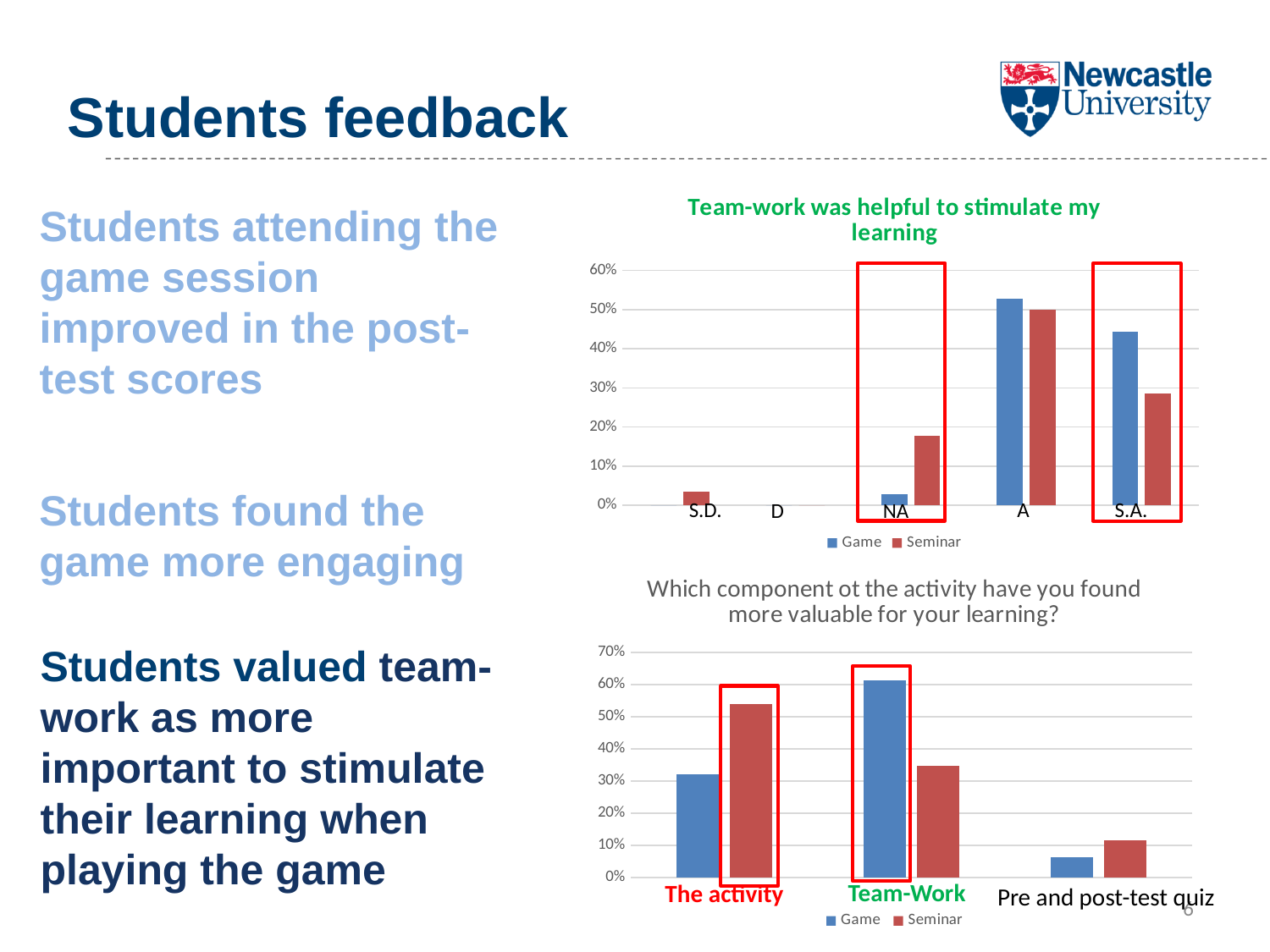
In the 'Team-work was helpful to stimulate my learning' chart, is the Seminar value for NA greater or less than 20%? less In the 'Team-work was helpful to stimulate my learning' chart, which category has the highest Game value? A In the 'Which component ot the activity have you found more valuable for your learning?' chart, which category has the highest Seminar value? The activity In the 'Which component ot the activity have you found more valuable for your learning?' chart, is the Game value for Team-Work greater or less than 50%? greater What kind of chart is the 'Team-work was helpful to stimulate my learning' chart? bar chart How many categories are shown on the x axis of the 'Which component ot the activity have you found more valuable for your learning?' chart? 3 In the 'Which component ot the activity have you found more valuable for your learning?' chart, which category has the highest Game value? Team-Work In the 'Which component ot the activity have you found more valuable for your learning?' chart, which category has the lowest Game value? Pre and post-test quiz In the 'Team-work was helpful to stimulate my learning' chart, for S.A., which series has the larger value, Game or Seminar? Game In the 'Which component ot the activity have you found more valuable for your learning?' chart, for The activity, which series has the larger value, Game or Seminar? Seminar How many series does the legend of the 'Team-work was helpful to stimulate my learning' chart list? 2 How many categories are shown on the x axis of the 'Team-work was helpful to stimulate my learning' chart? 5